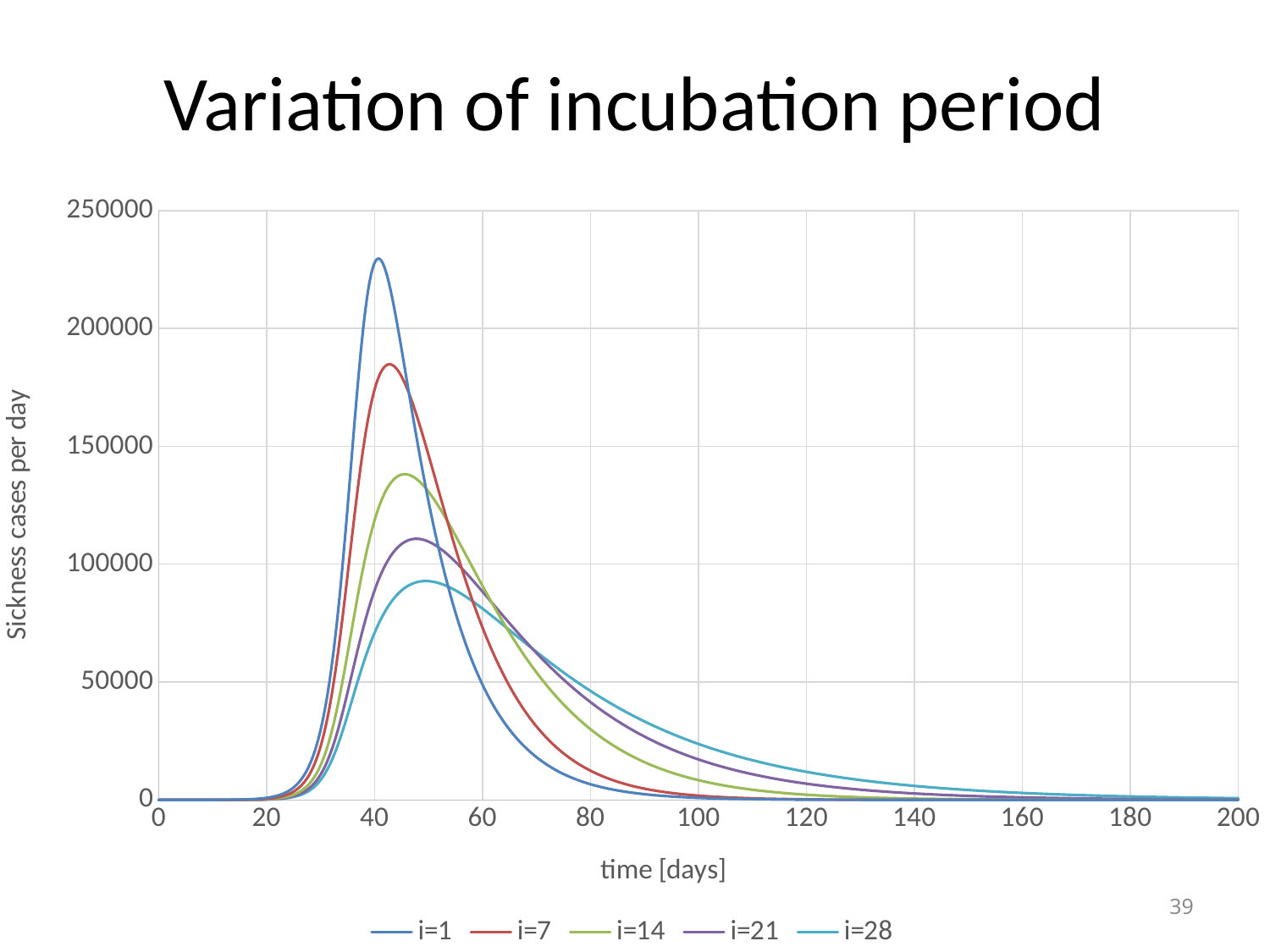
How many series does the legend list? 5 Is the peak value for the i=28 series greater or less than 100000? less Which series has the lowest peak of sickness cases per day? i=28 Is the peak value for the i=7 series greater or less than 150000? greater What is the title of the chart? Variation of incubation period Is the peak value for the i=14 series greater or less than 150000? less Do the values for the i=1 series rise or fall between day 60 and day 100? fall Which series has a higher peak, i=7 or i=14? i=7 Which series has a higher peak, i=21 or i=28? i=21 Which series reaches the highest peak of sickness cases per day? i=1 What kind of chart is shown on the slide? line chart